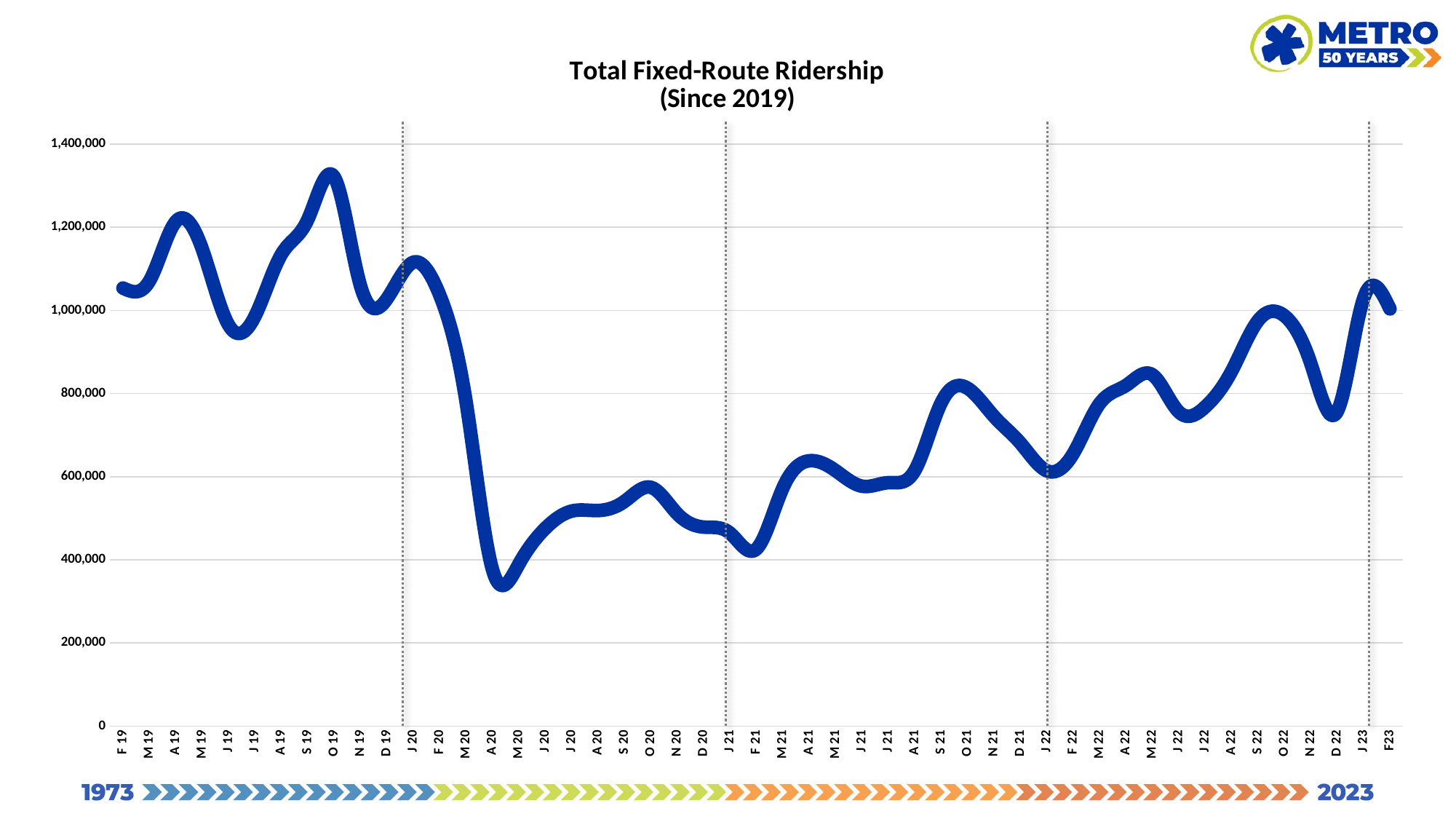
How many vertical dotted lines are drawn on the chart? 4 Is the value for F 19 greater or less than 1,000,000? greater Does ridership rise or fall from J 20 to A 20? fall Is the value for D 22 greater or less than 800,000? less Is the value for F 21 greater or less than 600,000? less Which month has the lowest ridership on the chart? A 20 What kind of chart is shown on the slide? line chart Which month has the highest ridership on the chart? O 19 Which is larger, the ridership for O 19 or for A 20? O 19 What is the title of the chart? Total Fixed-Route Ridership (Since 2019)